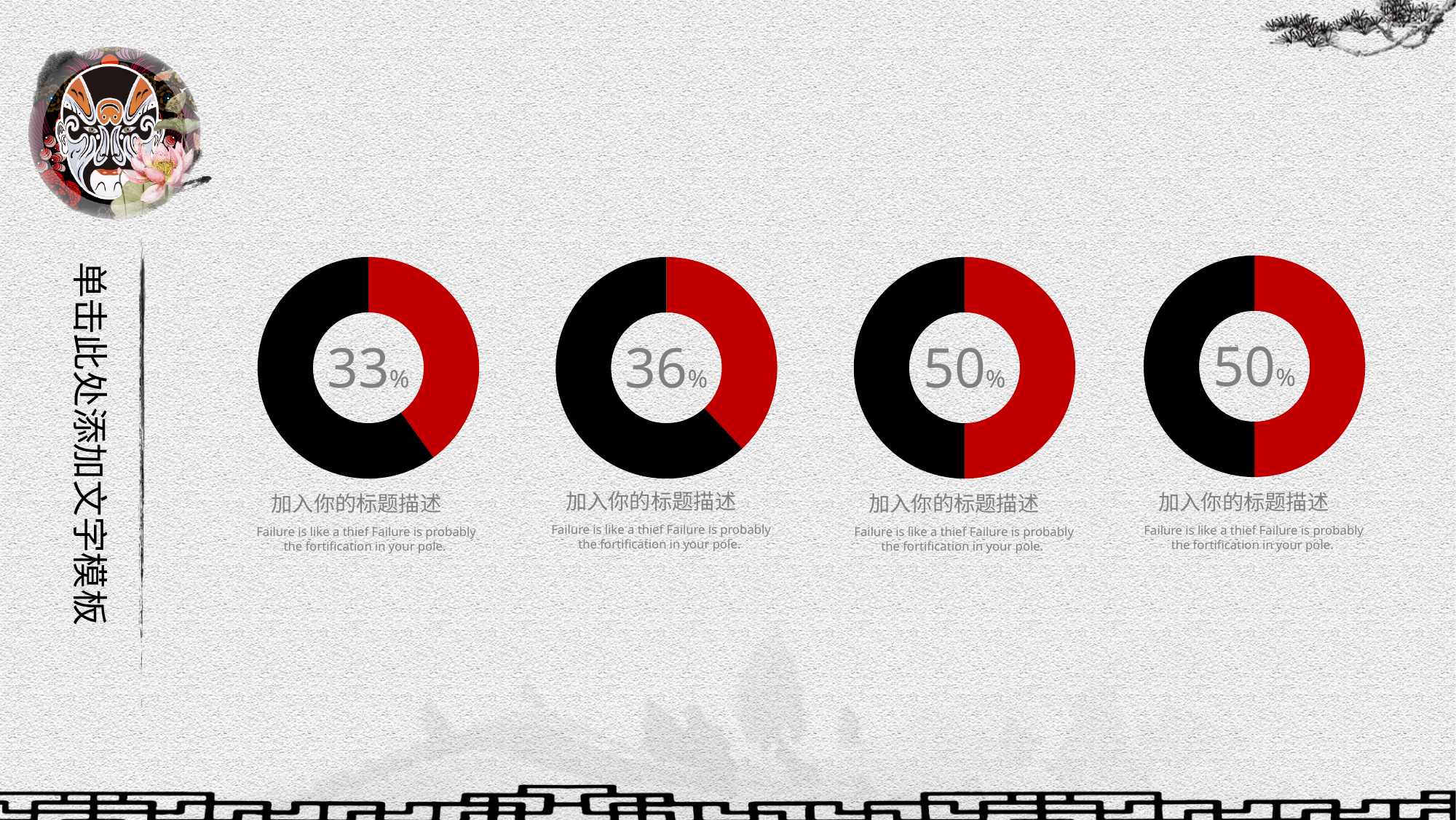
Which doughnut chart shows the lowest percentage? the leftmost chart (33%) What percentage is shown in the centre of the rightmost doughnut chart? 50% In the rightmost doughnut chart, what share of the ring is red? 50% Which shows a larger percentage, the leftmost doughnut chart or the second doughnut chart from the left? the second chart (36%) What kind of chart is shown four times on the slide? doughnut chart What is the difference between the percentage in the second doughnut chart and the percentage in the leftmost doughnut chart? 3% How many doughnut charts are on the slide? 4 What percentage is shown in the centre of the leftmost doughnut chart? 33% What two colours are used for the slices in each doughnut chart? red and black What percentage is shown in the centre of the third doughnut chart from the left? 50% What percentage is shown in the centre of the second doughnut chart from the left? 36% Is the percentage in the leftmost doughnut chart greater or less than 50%? less